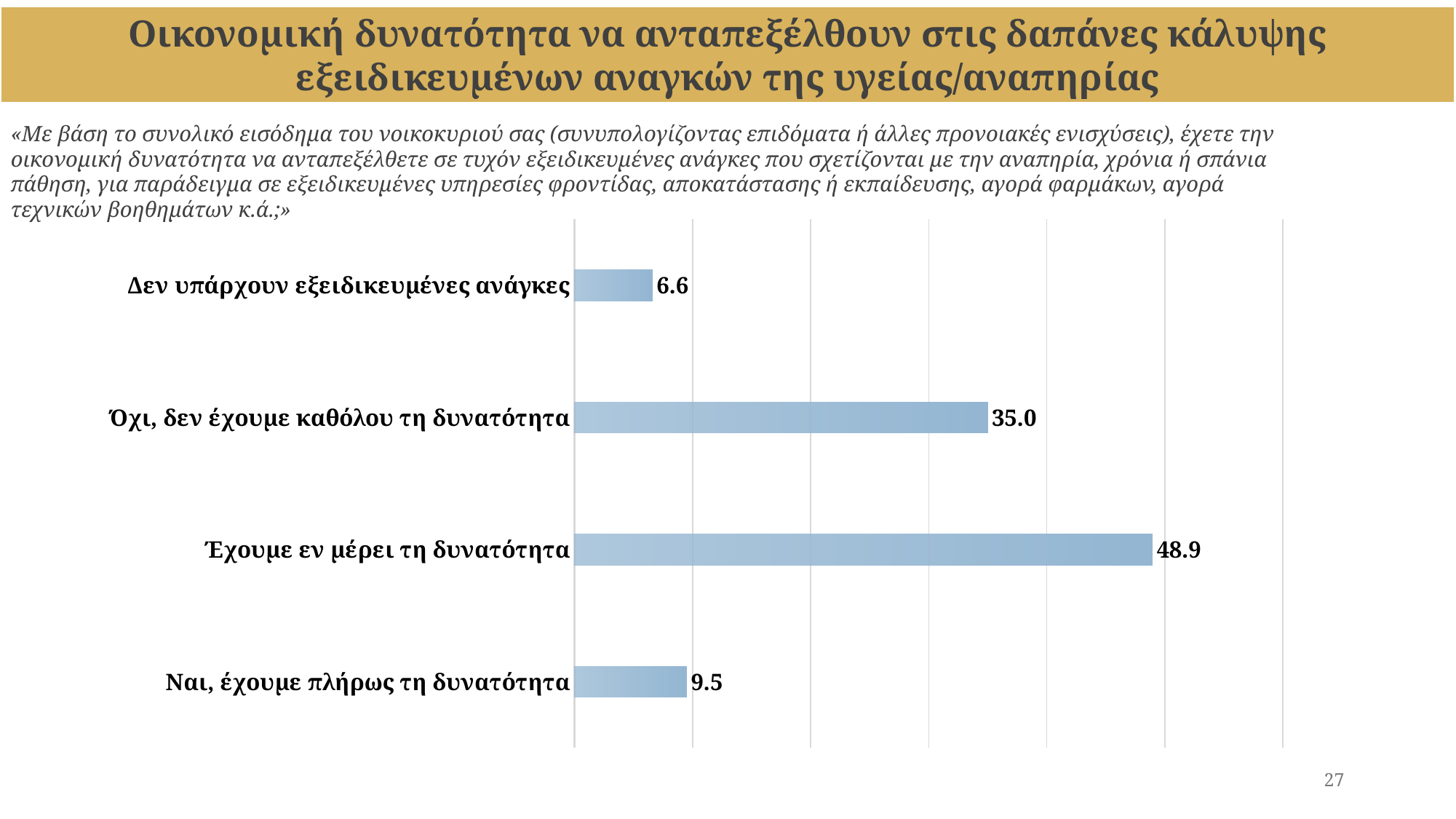
What colour are the bars in the chart? Blue What kind of chart is shown on the slide? Bar chart Which is larger, the value for "Ναι, έχουμε πλήρως τη δυνατότητα" or the value for "Δεν υπάρχουν εξειδικευμένες ανάγκες"? Ναι, έχουμε πλήρως τη δυνατότητα What is the value for "Όχι, δεν έχουμε καθόλου τη δυνατότητα"? 35.0 What is the value for "Δεν υπάρχουν εξειδικευμένες ανάγκες"? 6.6 What is the difference between the values for "Ναι, έχουμε πλήρως τη δυνατότητα" and "Δεν υπάρχουν εξειδικευμένες ανάγκες"? 2.9 How many categories are shown in the chart? 4 Which category has the lowest value? Δεν υπάρχουν εξειδικευμένες ανάγκες What is the difference between the values for "Έχουμε εν μέρει τη δυνατότητα" and "Όχι, δεν έχουμε καθόλου τη δυνατότητα"? 13.9 What is the value for "Ναι, έχουμε πλήρως τη δυνατότητα"? 9.5 What is the value for "Έχουμε εν μέρει τη δυνατότητα"? 48.9 Which category has the highest value? Έχουμε εν μέρει τη δυνατότητα